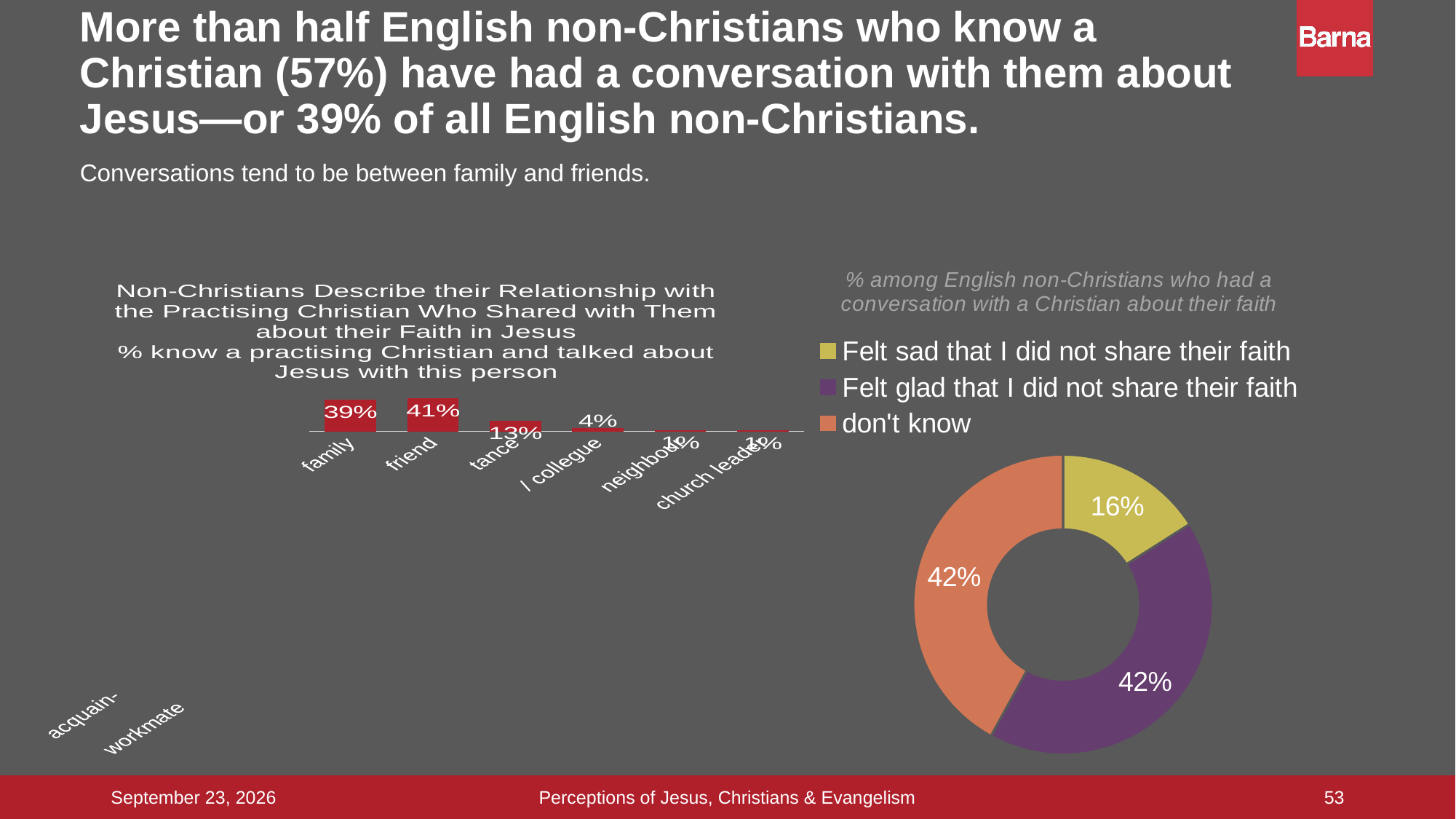
In the doughnut chart on the right, what percentage felt sad that they did not share their faith? 16% In the bar chart on the left, which category has the highest value? friend In the bar chart on the left, what percentage is shown for family? 39% In the doughnut chart on the right, what percentage felt glad that they did not share their faith? 42% How many entries does the legend of the doughnut chart on the right list? 3 In the bar chart on the left, what percentage is shown for friend? 41% In the bar chart on the left, what is the difference between the values for friend and family? 2% What kind of chart is the chart on the left of the slide? bar chart In the bar chart on the left, which is larger, the value for family or the value for acquaintance? family How many categories are shown in the bar chart on the left? 6 In the doughnut chart on the right, which response has the smallest share? Felt sad that I did not share their faith In the bar chart on the left, what percentage is shown for acquaintance? 13%